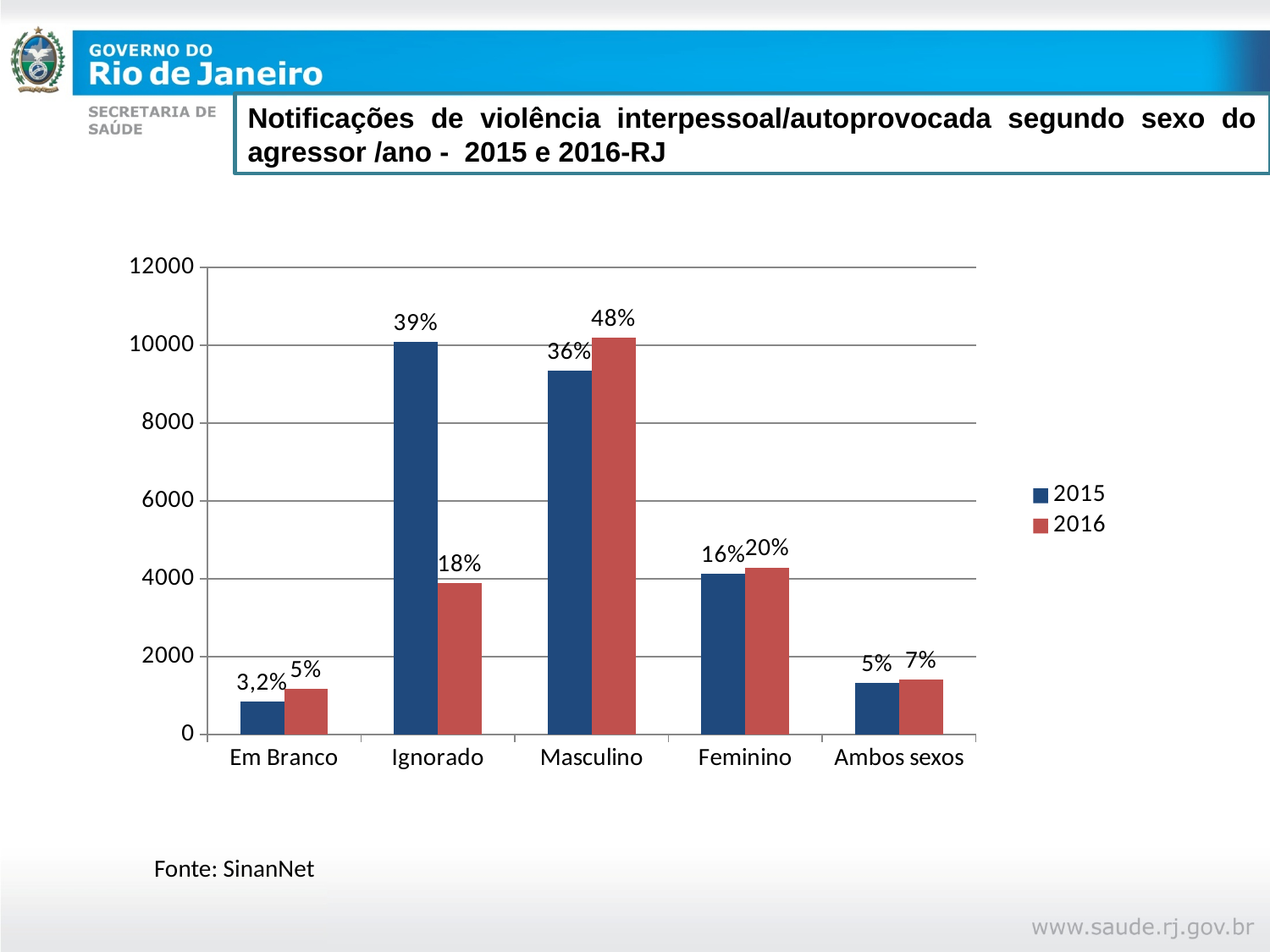
Which category has the highest 2015 bar? Ignorado Is the 2015 value for Em Branco greater or less than 2000? less For Ignorado, which year has the larger bar, 2015 or 2016? 2015 What percentage label is shown on the 2015 bar for Em Branco? 3,2% How many categories are shown on the x axis? 5 What kind of chart is shown on the slide? bar chart How many series does the legend list? 2 What percentage label is shown on the 2016 bar for Masculino? 48% Which category has the lowest 2015 bar? Em Branco For Masculino, which year has the larger bar, 2015 or 2016? 2016 What percentage label is shown on the 2015 bar for Ignorado? 39% Is the 2015 value for Masculino greater or less than 8000? greater